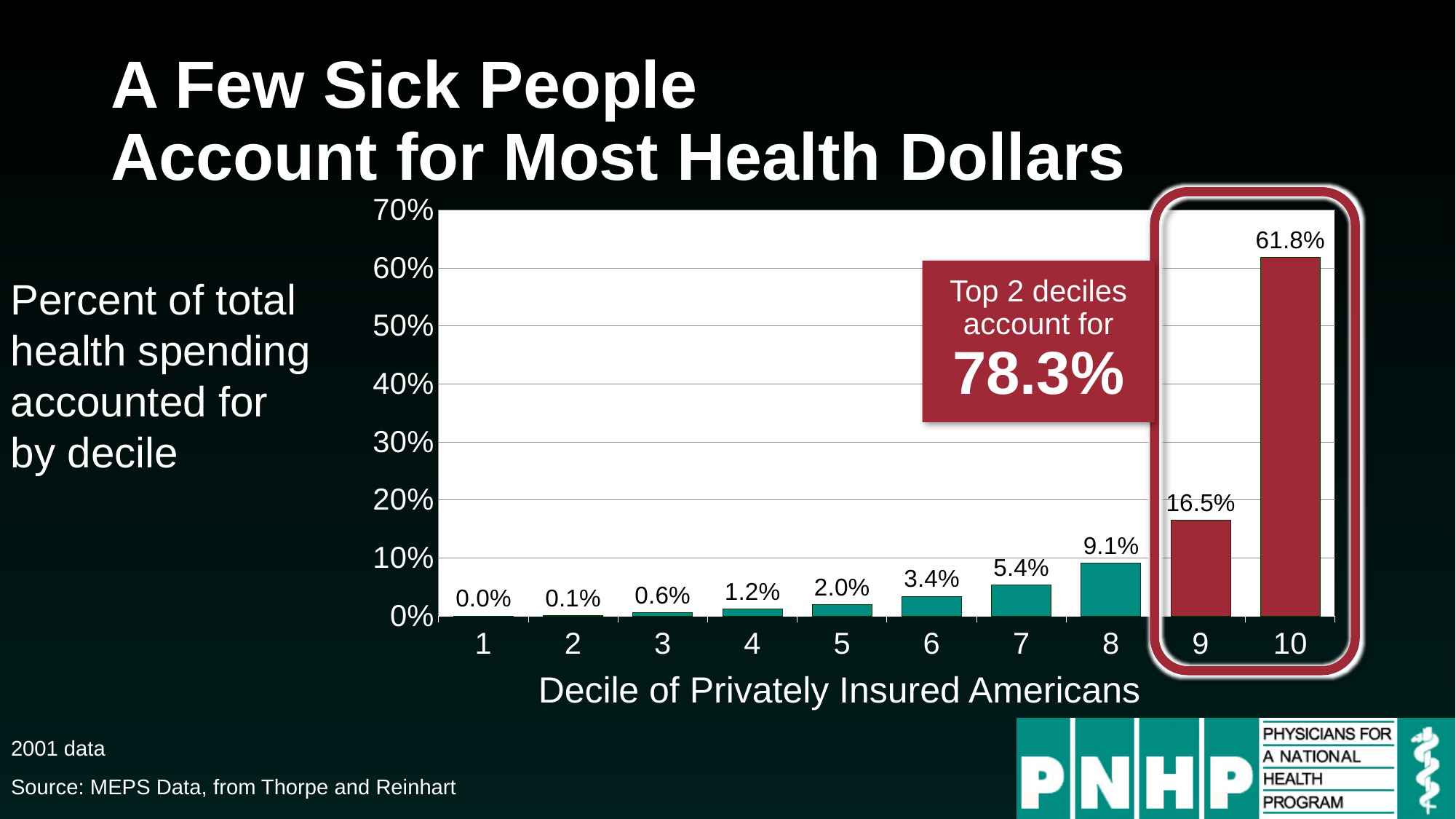
Which has a larger value, decile 7 or decile 8? Decile 8 Is the value for decile 10 greater or less than 60%? greater What kind of chart is shown on the slide? Bar chart Do the values rise or fall as the decile number increases from 1 to 10? Rise What is the difference between the values for decile 10 and decile 9? 45.3% What is the value shown for decile 5? 2.0% What is the value shown for decile 8? 9.1% How many deciles are shown on the x axis? 10 What percent of total health spending is accounted for by decile 9? 16.5% Which decile accounts for the highest share of total health spending? 10 What percent of total health spending is accounted for by decile 10? 61.8% Which decile accounts for the lowest share of total health spending? 1